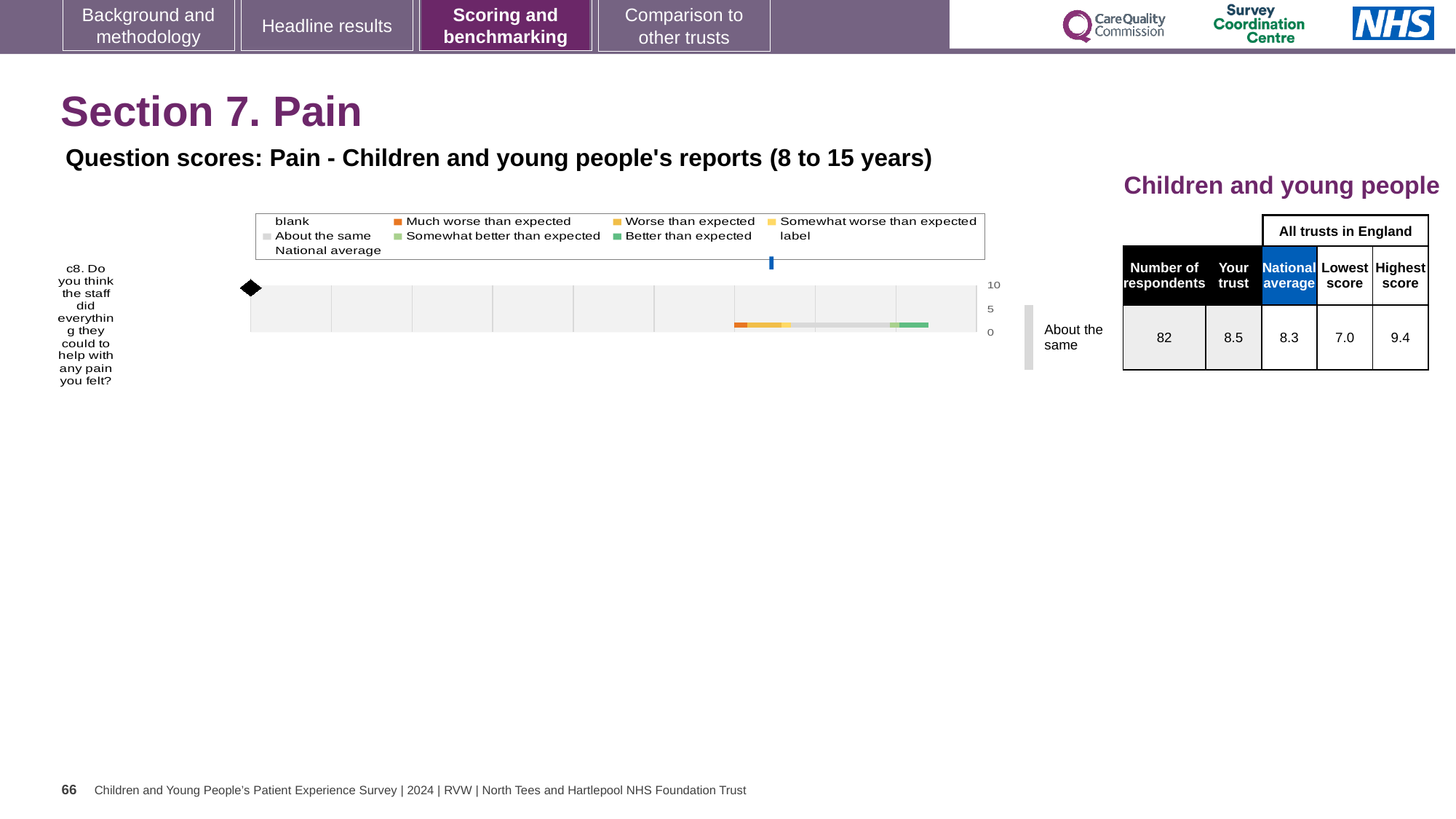
Which question code is plotted on the chart? c8 According to the table, what is the 'Your trust' score for question c8? 8.5 According to the table, what is the highest score among all trusts in England for question c8? 9.4 What kind of chart is used to show the question score for c8? bar chart What benchmark category is the trust's result for question c8 placed in? About the same How many respondents answered question c8? 82 How many survey questions are plotted on the chart? 1 According to the table, what is the lowest score among all trusts in England for question c8? 7.0 What is the difference between the highest score and the lowest score for question c8? 2.4 According to the table, what is the national average score for question c8? 8.3 Which is larger for question c8: the 'Your trust' score or the national average? Your trust What is the highest value shown on the chart's score axis? 10